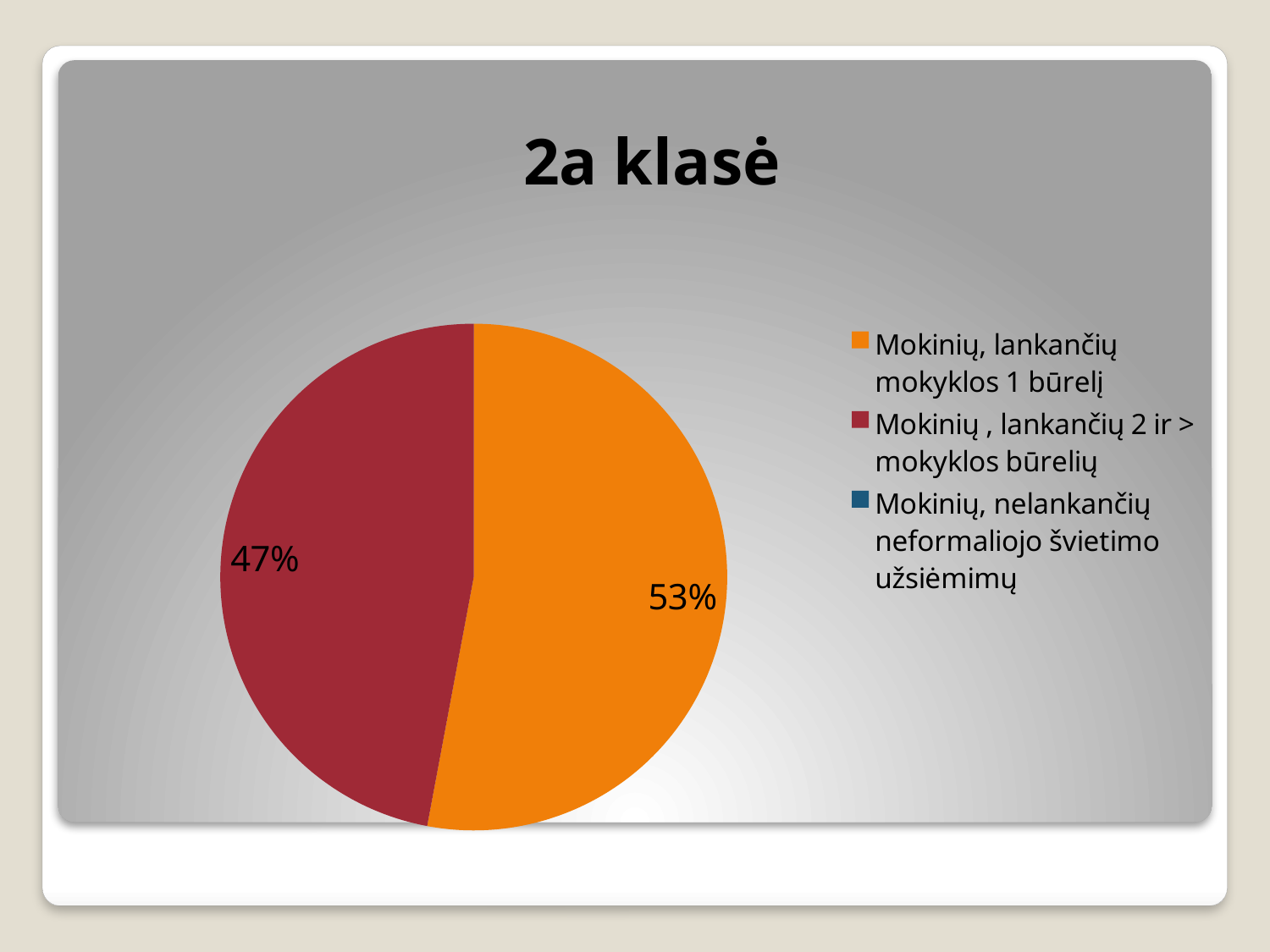
What is the difference in percentage points between the 53% slice and the 47% slice? 6 What share of the pie is labelled for "Mokinių , lankančių 2 ir > mokyklos būrelių"? 47% How many slices are visible in the pie? 2 What colour is the slice for "Mokinių, lankančių mokyklos 1 būrelį"? orange What is the total of the two labelled slices? 100% What share of the pie is labelled for "Mokinių, lankančių mokyklos 1 būrelį"? 53% Which category has the largest slice of the pie? Mokinių, lankančių mokyklos 1 būrelį What type of chart is shown on the slide? pie chart Which of the two visible slices is smaller? Mokinių , lankančių 2 ir > mokyklos būrelių Which is larger: the share for "Mokinių, lankančių mokyklos 1 būrelį" or the share for "Mokinių , lankančių 2 ir > mokyklos būrelių"? Mokinių, lankančių mokyklos 1 būrelį How many entries does the legend list? 3 What is the title of the chart? 2a klasė